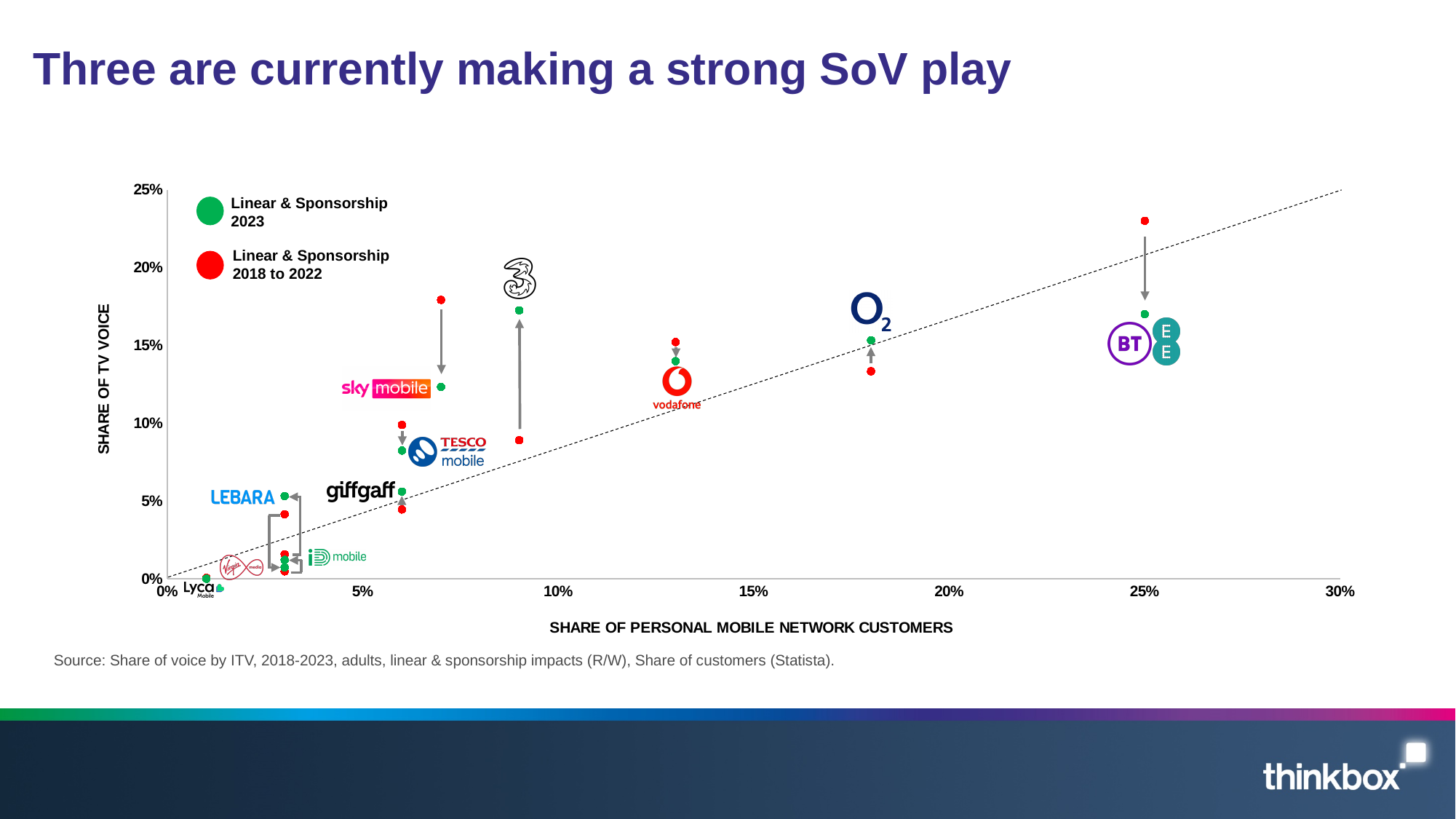
How many series does the legend list? 2 Is the 2023 share of TV voice for Tesco Mobile greater or less than 10%? less What is the label of the y axis? SHARE OF TV VOICE Is the 2018 to 2022 share of TV voice for BT/EE greater or less than 20%? greater For Three, which is larger: the 2023 share of TV voice or the 2018 to 2022 share of TV voice? 2023 What kind of chart is shown on the slide? Scatter chart For Sky Mobile, which is larger: the 2023 share of TV voice or the 2018 to 2022 share of TV voice? 2018 to 2022 What is the label of the x axis? SHARE OF PERSONAL MOBILE NETWORK CUSTOMERS Which brand has the highest 2018 to 2022 share of TV voice? BT/EE Is the 2018 to 2022 share of TV voice for Three greater or less than 10%? less